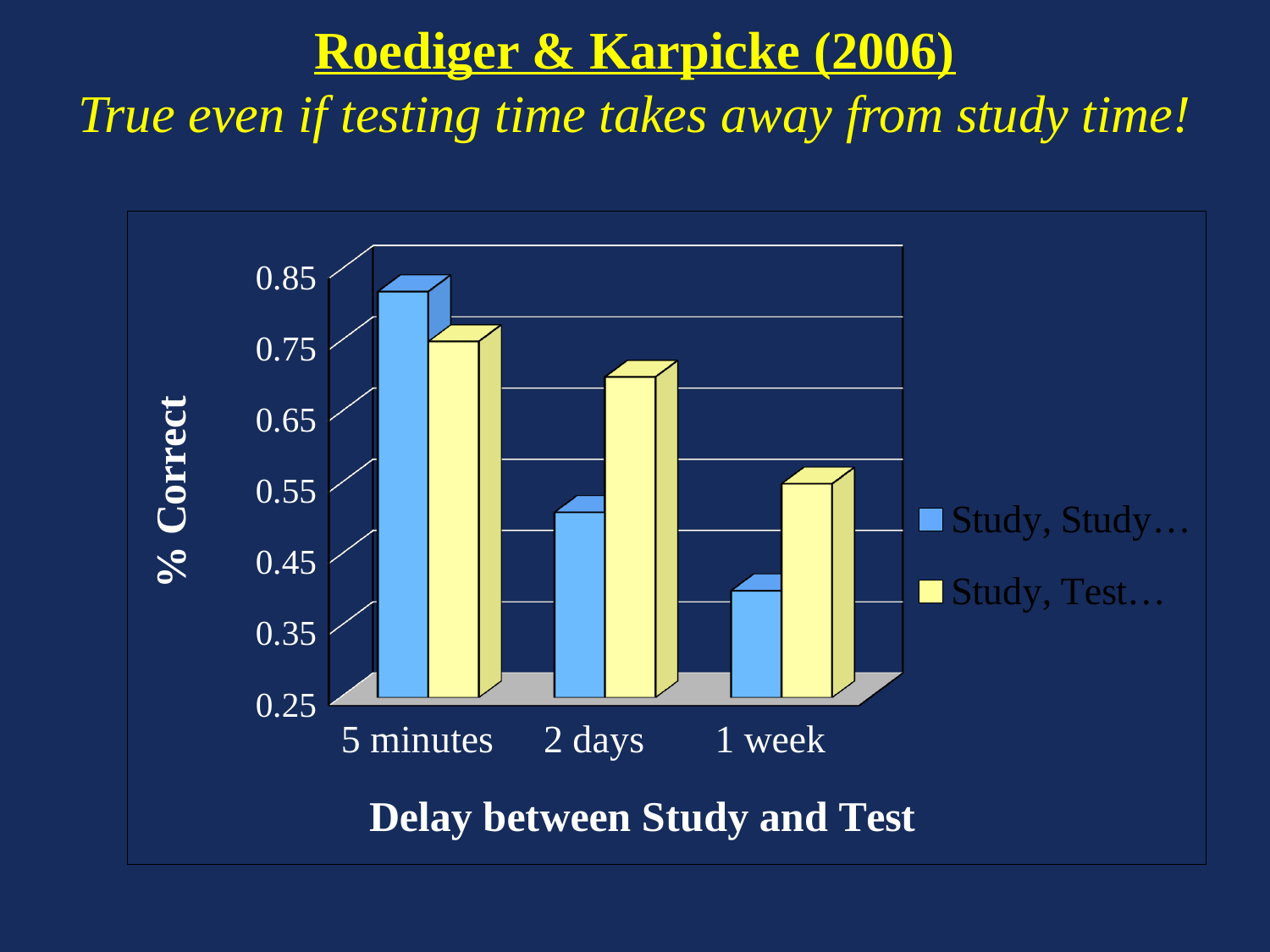
How many delay categories are shown on the x axis? 3 Is the value for Study, Study… at 5 minutes greater or less than 0.75? greater Which delay category has the lowest value for the Study, Test… series? 1 week What kind of chart is shown on the slide? bar chart Do the values for the Study, Study… series rise or fall as the delay between study and test increases? fall What is the title of the vertical axis? % Correct At a delay of 5 minutes, which series has the larger value: Study, Study… or Study, Test…? Study, Study… At a delay of 1 week, which series has the larger value: Study, Study… or Study, Test…? Study, Test… Is the value for Study, Study… at 1 week greater or less than 0.45? less Is the value for Study, Test… at 2 days greater or less than 0.65? greater How many series does the legend list? 2 Which delay category has the highest value for the Study, Study… series? 5 minutes